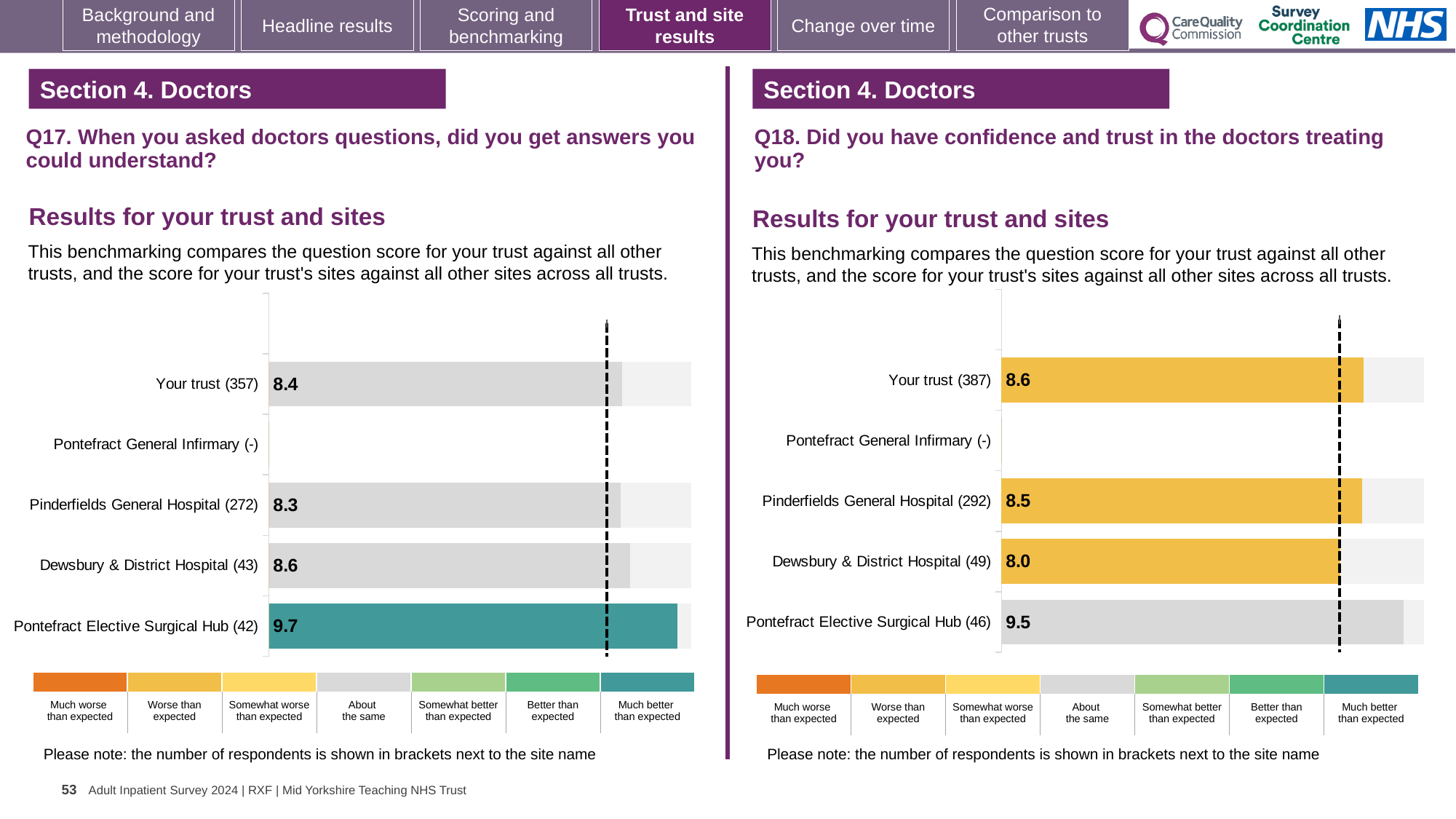
In the Q17 chart on the left, what is the difference between the scores for Pontefract Elective Surgical Hub and Dewsbury & District Hospital? 1.1 In the Q18 chart on the right, what is the score for Pinderfields General Hospital? 8.5 In the Q17 chart on the left, what is the score for Your trust? 8.4 What kind of chart is used in the Q17 chart on the left? Bar chart In the Q18 chart on the right, which site has the lowest score shown? Dewsbury & District Hospital In the Q18 chart on the right, which is larger: the score for Your trust or the score for Pinderfields General Hospital? Your trust In the Q17 chart on the left, which site with a score shown has the lowest score? Pinderfields General Hospital In the Q18 chart on the right, what is the difference between the scores for Pontefract Elective Surgical Hub and Your trust? 0.9 In the Q17 chart on the left, which site has the highest score? Pontefract Elective Surgical Hub In the Q18 chart on the right, what is the score for Dewsbury & District Hospital? 8.0 In the Q17 chart on the left, how many respondents are shown for Dewsbury & District Hospital? 43 In the Q17 chart on the left, what is the score for Pontefract Elective Surgical Hub? 9.7